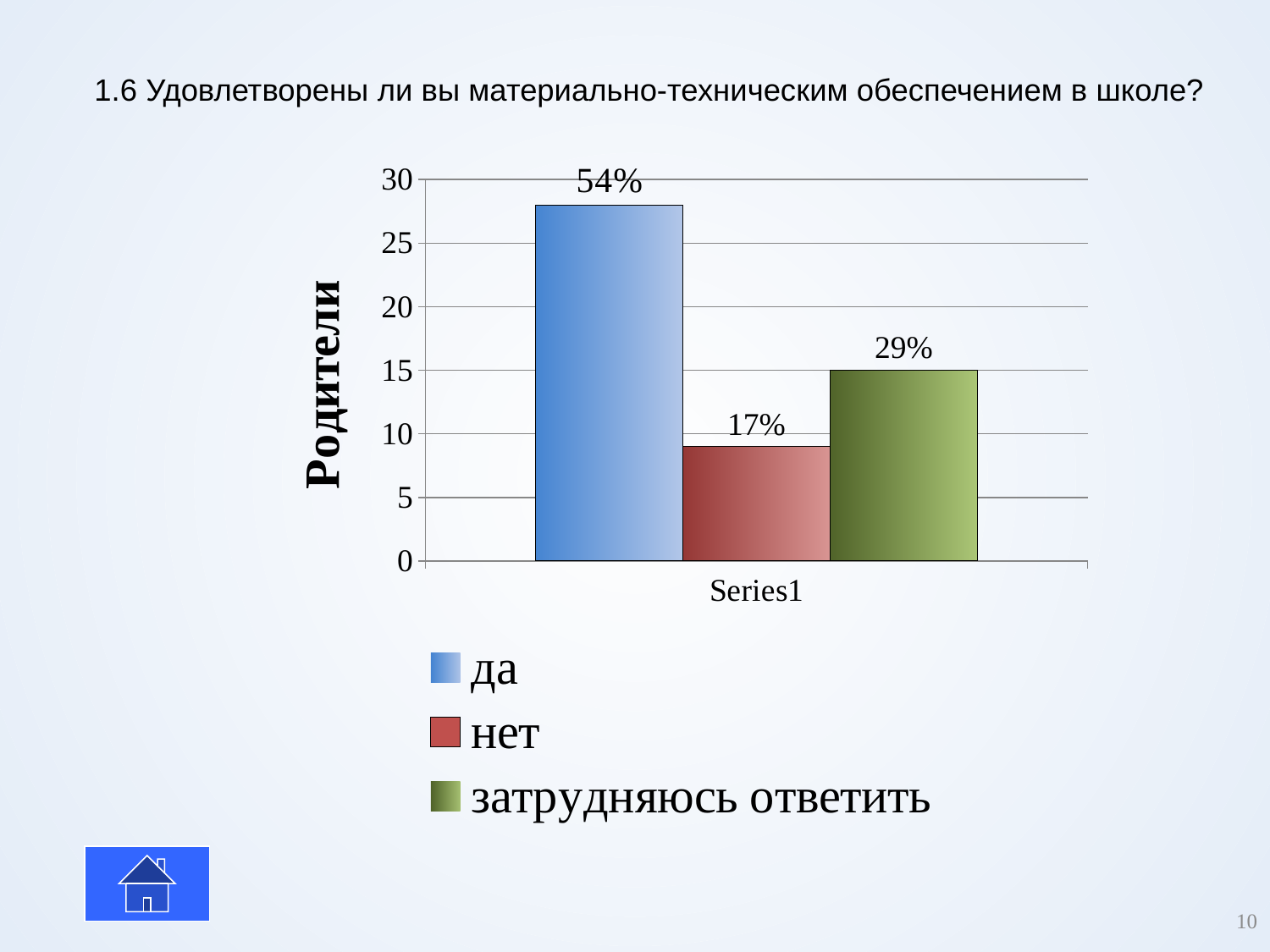
Is the bar for "нет" greater or less than 10 on the vertical axis? less Is the bar for "да" greater or less than 25 on the vertical axis? greater How many bars are plotted in the chart? 3 What data label is shown on the bar for "нет"? 17% What data label is shown on the bar for "да"? 54% Which answer option has the highest bar? да Which bar is taller, "нет" or "затрудняюсь ответить"? затрудняюсь ответить What is the title of the vertical axis? Родители What is the difference between the data labels for "затрудняюсь ответить" and "нет"? 12% What data label is shown on the bar for "затрудняюсь ответить"? 29% What is the difference between the data labels for "да" and "нет"? 37% Which answer option has the lowest bar? нет